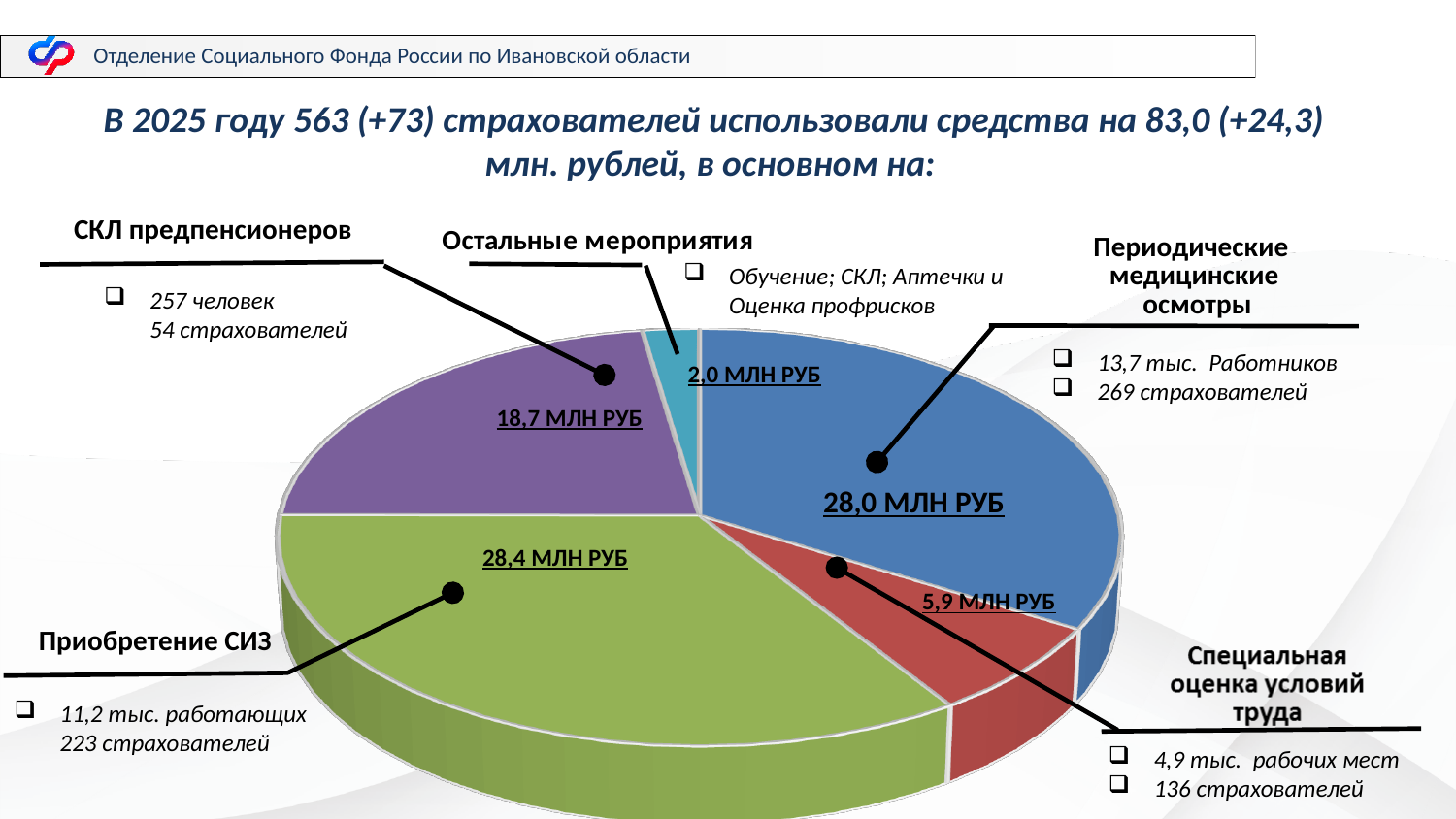
What is the difference between the values for СКЛ предпенсионеров and Остальные мероприятия? 16,7 млн руб How many slices does the pie chart have? 5 What is the difference between the values for Приобретение СИЗ and Специальная оценка условий труда? 22,5 млн руб What is the value shown for Остальные мероприятия? 2,0 МЛН РУБ What type of chart is shown on the slide? Pie chart What colour is the slice for Приобретение СИЗ? Green What is the value shown for Приобретение СИЗ? 28,4 МЛН РУБ What is the value shown for Специальная оценка условий труда? 5,9 МЛН РУБ What is the value shown for Периодические медицинские осмотры? 28,0 МЛН РУБ Which category has the smallest slice of the pie? Остальные мероприятия What is the value shown for СКЛ предпенсионеров? 18,7 МЛН РУБ Which is larger: Приобретение СИЗ or Специальная оценка условий труда? Приобретение СИЗ